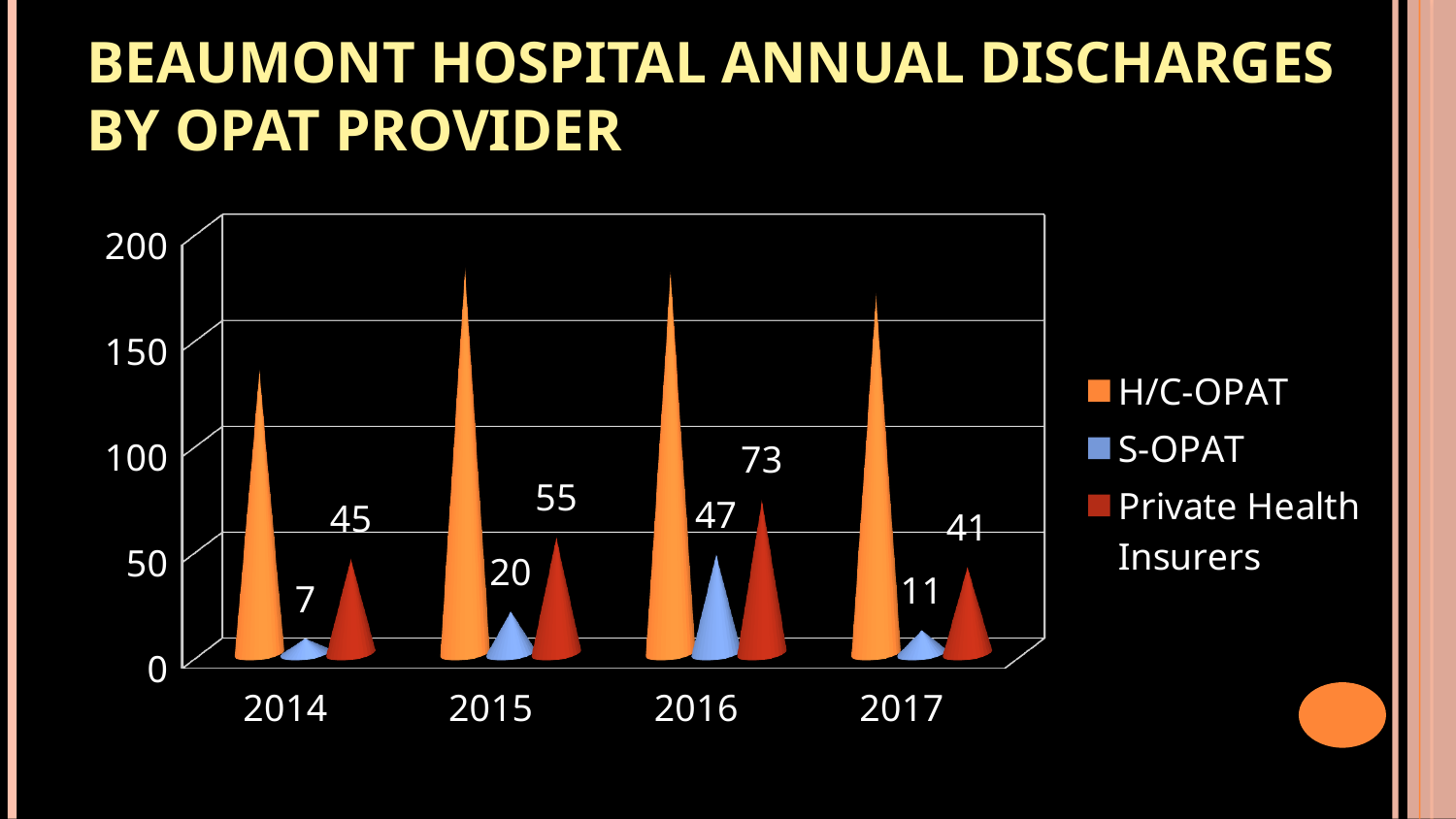
What is the Private Health Insurers value for 2015? 55 In which year is the Private Health Insurers value highest? 2016 Does the Private Health Insurers value rise or fall from 2016 to 2017? fall How many years are shown on the x axis? 4 Is the H/C-OPAT value for 2015 greater or less than 150? greater What is the S-OPAT value for 2014? 7 Is the H/C-OPAT value for 2014 greater or less than 100? greater Which is larger in 2015: the S-OPAT value or the Private Health Insurers value? Private Health Insurers What is the S-OPAT value for 2016? 47 In which year is the S-OPAT value lowest? 2014 What is the difference between the Private Health Insurers value and the S-OPAT value in 2017? 30 How many series does the legend list? 3